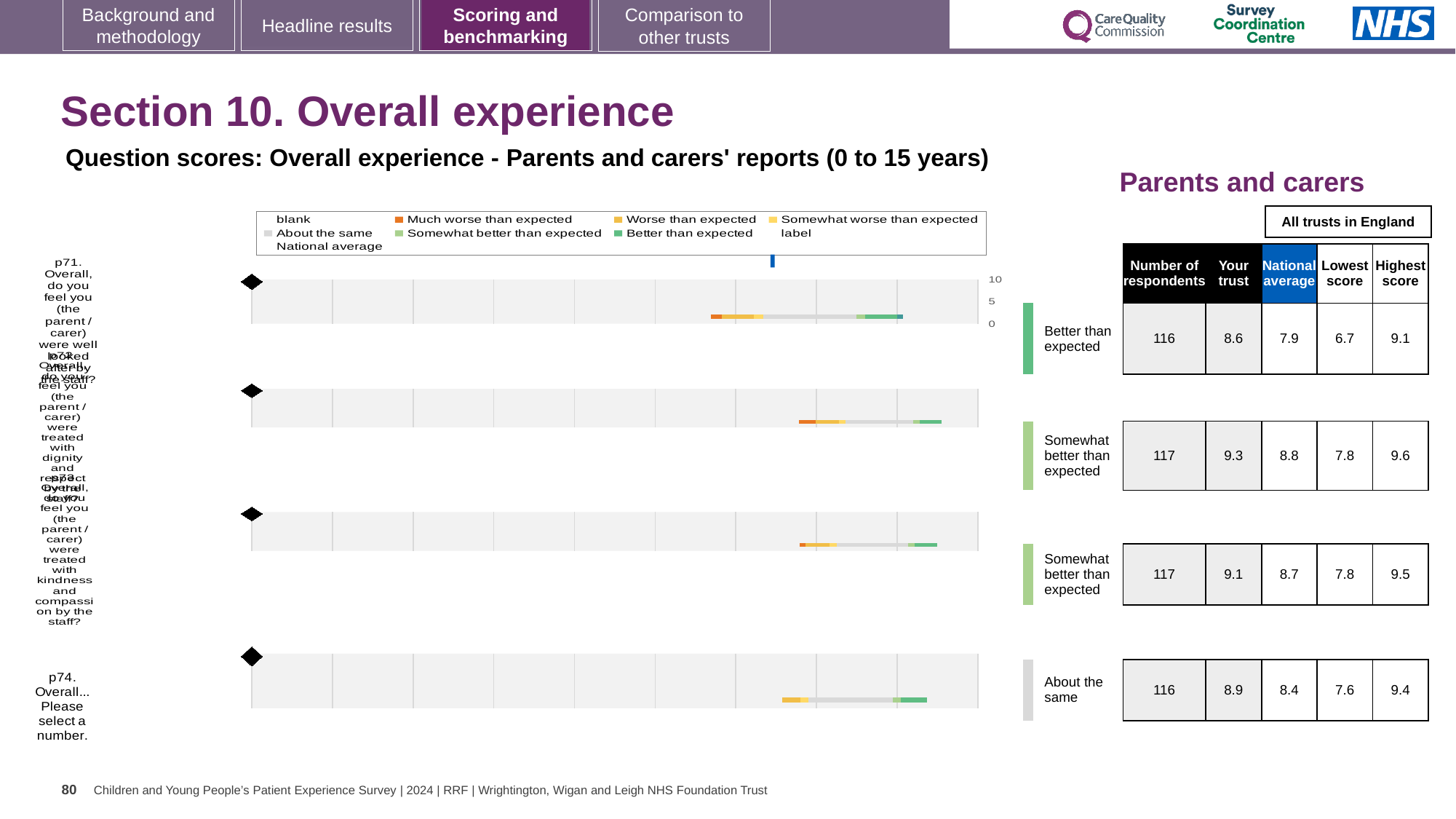
Which question has the lowest 'Your trust' score? p71 What kind of chart is used to show the question scores on this slide? bar chart What is the highest score across all trusts in England for question p72? 9.6 For question p73, which is larger: the 'Your trust' score or the national average? Your trust Which question has the highest 'Your trust' score? p72 What is the highest value shown on the chart's axis? 10 What is the 'Your trust' score for question p71? 8.6 Which colour in the legend represents 'Much worse than expected'? orange What is the national average for question p74? 8.4 What is the difference between the 'Your trust' score and the national average for question p72? 0.5 How many survey questions (rows) are plotted in the chart? 4 What is the number of respondents for question p72? 117